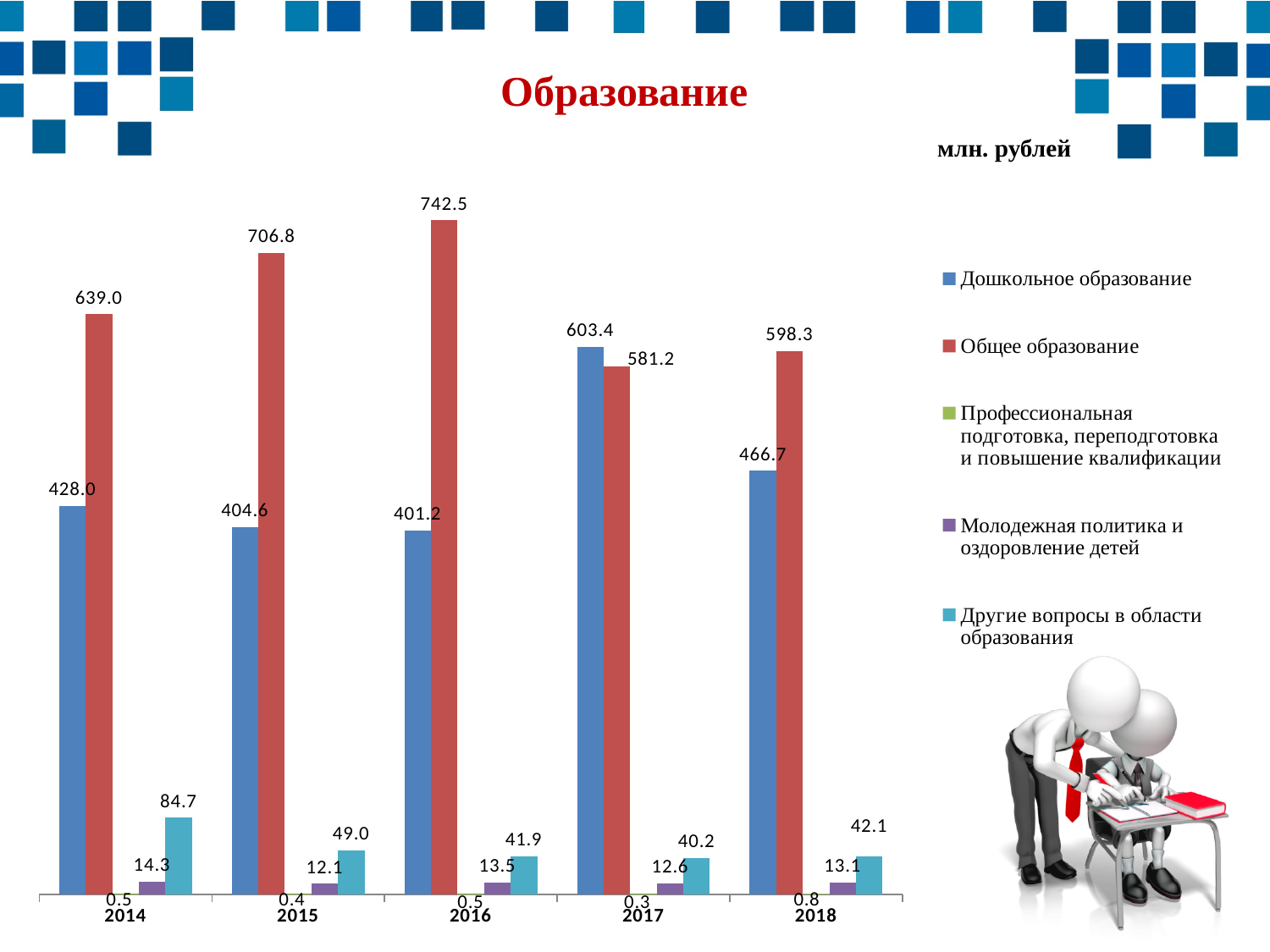
What is the value for Молодежная политика и оздоровление детей in 2018? 13.1 What is the value for Дошкольное образование in 2017? 603.4 How many years are shown on the x axis? 5 In 2017, which is larger: Дошкольное образование or Общее образование? Дошкольное образование In which year is Общее образование highest? 2016 What kind of chart is shown on the slide? Bar chart In which year is Дошкольное образование lowest? 2016 What is the value for Другие вопросы в области образования in 2014? 84.7 What unit is stated for the values on the chart? млн. рублей What is the value for Общее образование in 2016? 742.5 What is the difference between Общее образование and Дошкольное образование in 2014? 211.0 How many series does the legend list? 5